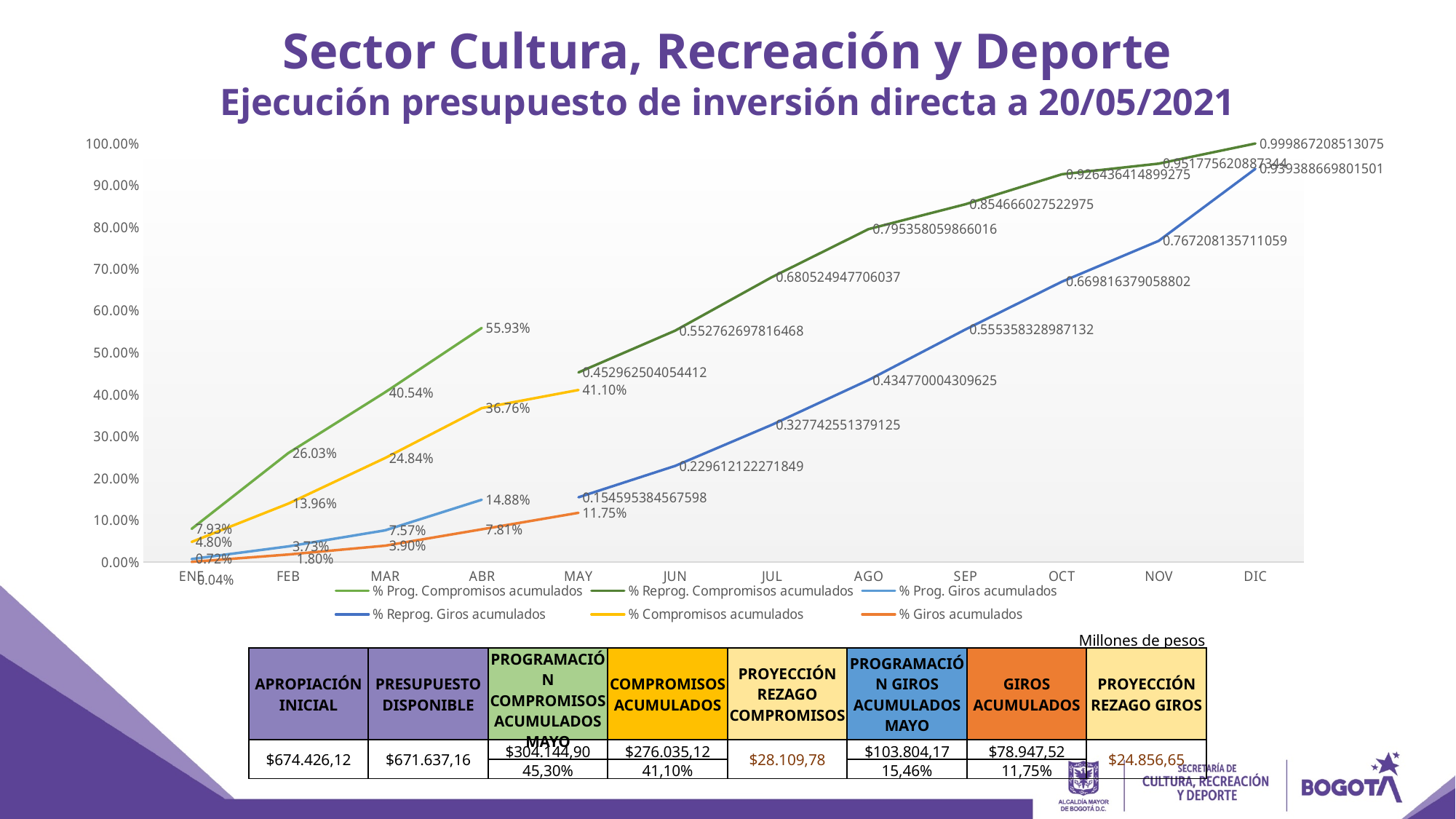
Does the % Compromisos acumulados line rise or fall from ENE to MAY? Rises In MAR, which is larger: % Prog. Giros acumulados or % Giros acumulados? % Prog. Giros acumulados What is the subtitle of the chart slide below 'Sector Cultura, Recreación y Deporte'? Ejecución presupuesto de inversión directa a 20/05/2021 What type of chart is shown on the slide? Line chart What is the data label for % Reprog. Compromisos acumulados in DIC? 0.999867208513075 In ABR, what is the difference between % Prog. Compromisos acumulados (55.93%) and % Compromisos acumulados (36.76%)? 19.17 percentage points How many series does the chart legend list? 6 How many months are shown along the x axis of the chart? 12 Is the value for % Reprog. Giros acumulados in OCT greater or less than 60%? greater What is the value of % Compromisos acumulados in MAY? 41.10% What is the value of % Giros acumulados in MAY? 11.75% What is the value of % Prog. Compromisos acumulados in ABR? 55.93%